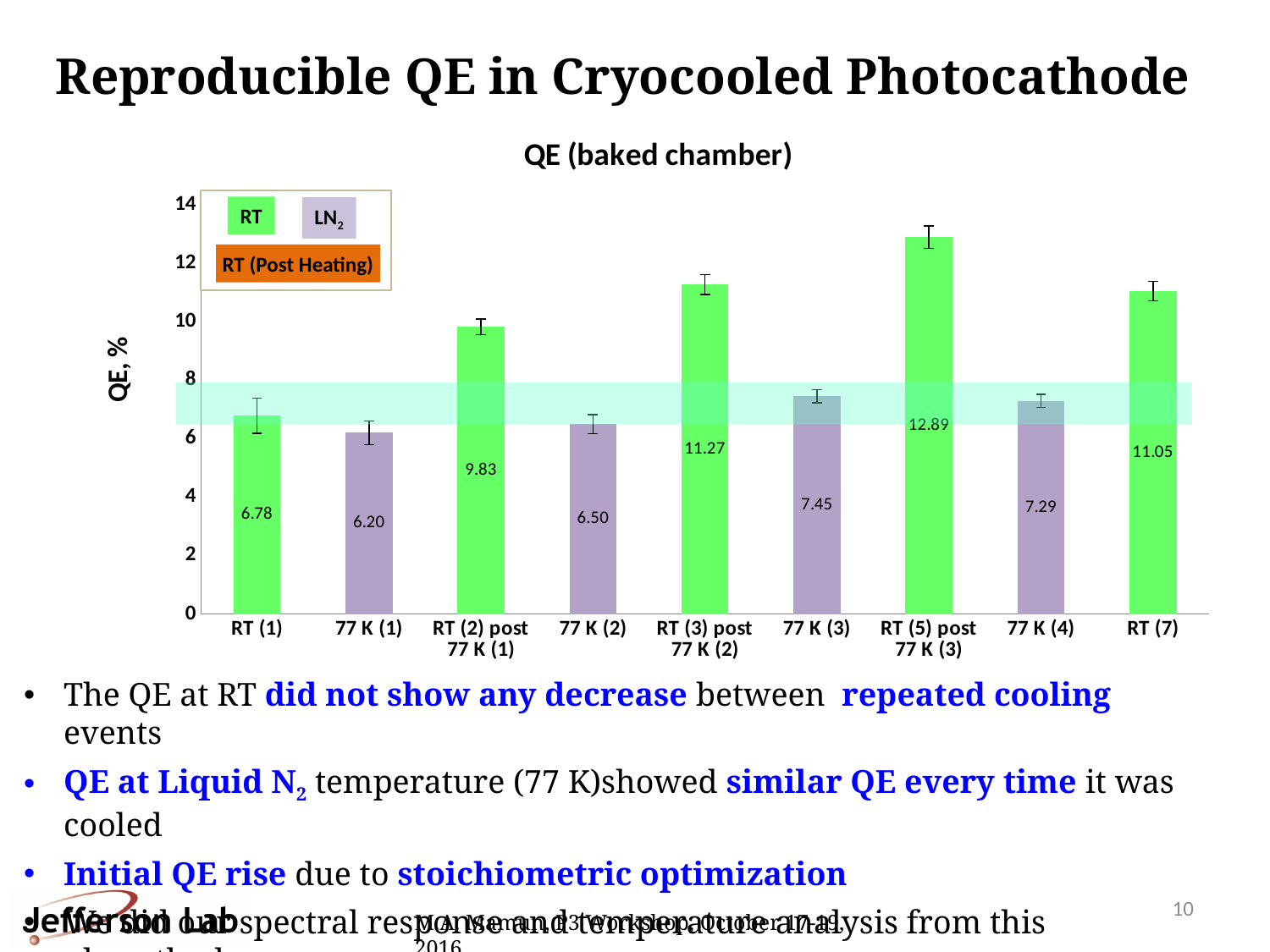
What is the QE value for RT (5) post 77 K (3)? 12.89 How many categories are shown on the x axis? 9 What is the QE value for 77 K (3)? 7.45 How many series does the legend list? 3 What is the QE value for RT (1)? 6.78 Which is larger, the QE value for 77 K (4) or for 77 K (1)? 77 K (4) What is the difference between the QE values for RT (3) post 77 K (2) and 77 K (2)? 4.77 Which category has the highest QE value? RT (5) post 77 K (3) Which category has the lowest QE value? 77 K (1) What is the title of the chart? QE (baked chamber) What is the QE value for RT (7)? 11.05 What kind of chart is shown on the slide? bar chart